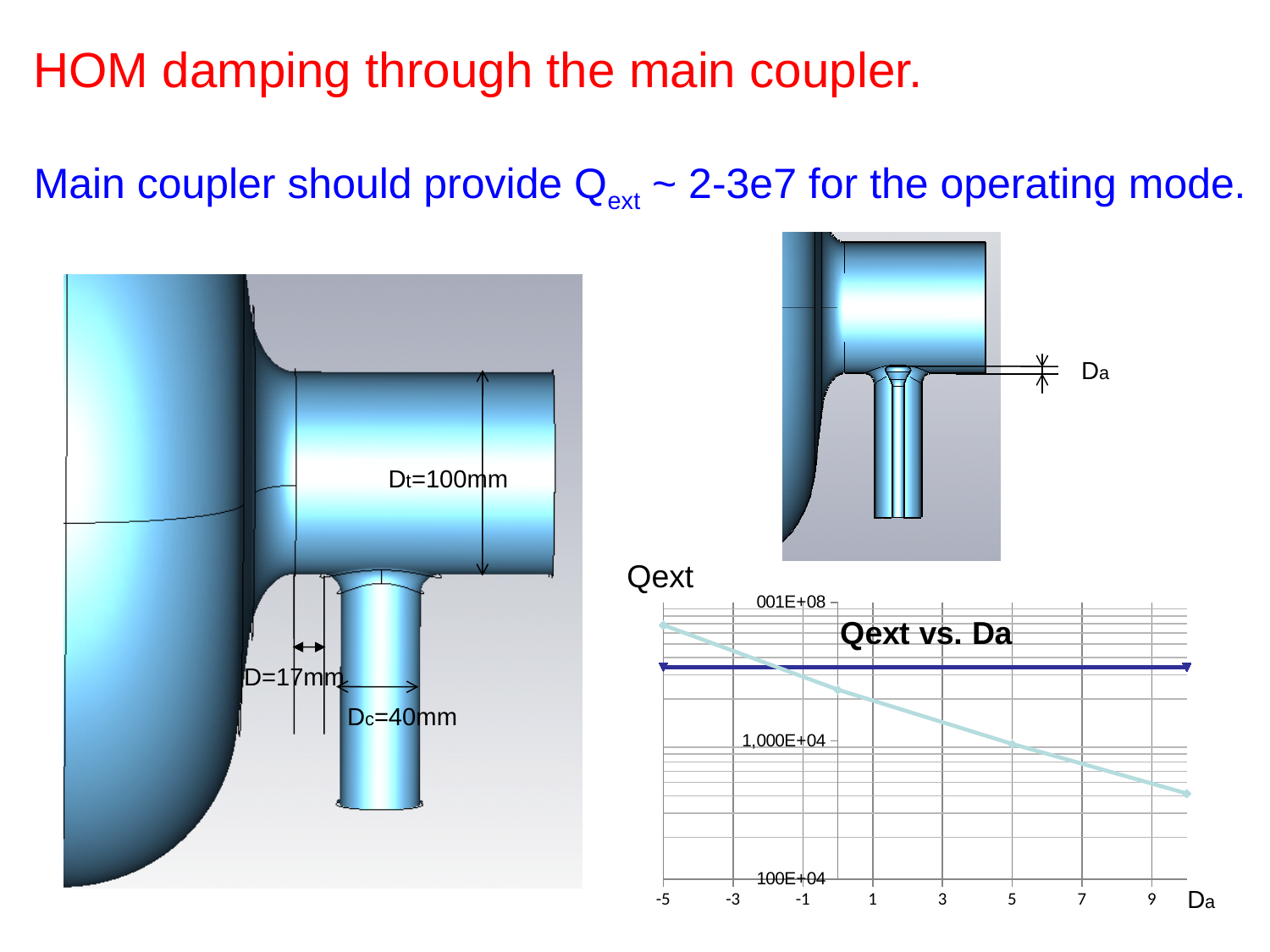
In the "Qext vs. Da" chart, is the light blue line's value higher at Da = -5 or at its rightmost point? Da = -5 What is the title of the chart on the right of the slide? Qext vs. Da What kind of chart is the "Qext vs. Da" chart? line chart In the "Qext vs. Da" chart, is the light blue line's value at Da = -5 greater or less than 1,000E+04? greater How many lines are plotted in the "Qext vs. Da" chart? 2 In the "Qext vs. Da" chart, is the dark blue horizontal line greater or less than 1,000E+04? greater In the "Qext vs. Da" chart, at which Da value does the light blue line reach its highest value? -5 In the "Qext vs. Da" chart, at Da = 5, is the light blue line above or below the dark blue line? below In the "Qext vs. Da" chart, does the light blue line rise or fall as Da increases? fall What label is shown on the horizontal axis of the "Qext vs. Da" chart? Da In the "Qext vs. Da" chart, is the light blue line's value at its rightmost point greater or less than 1,000E+04? less